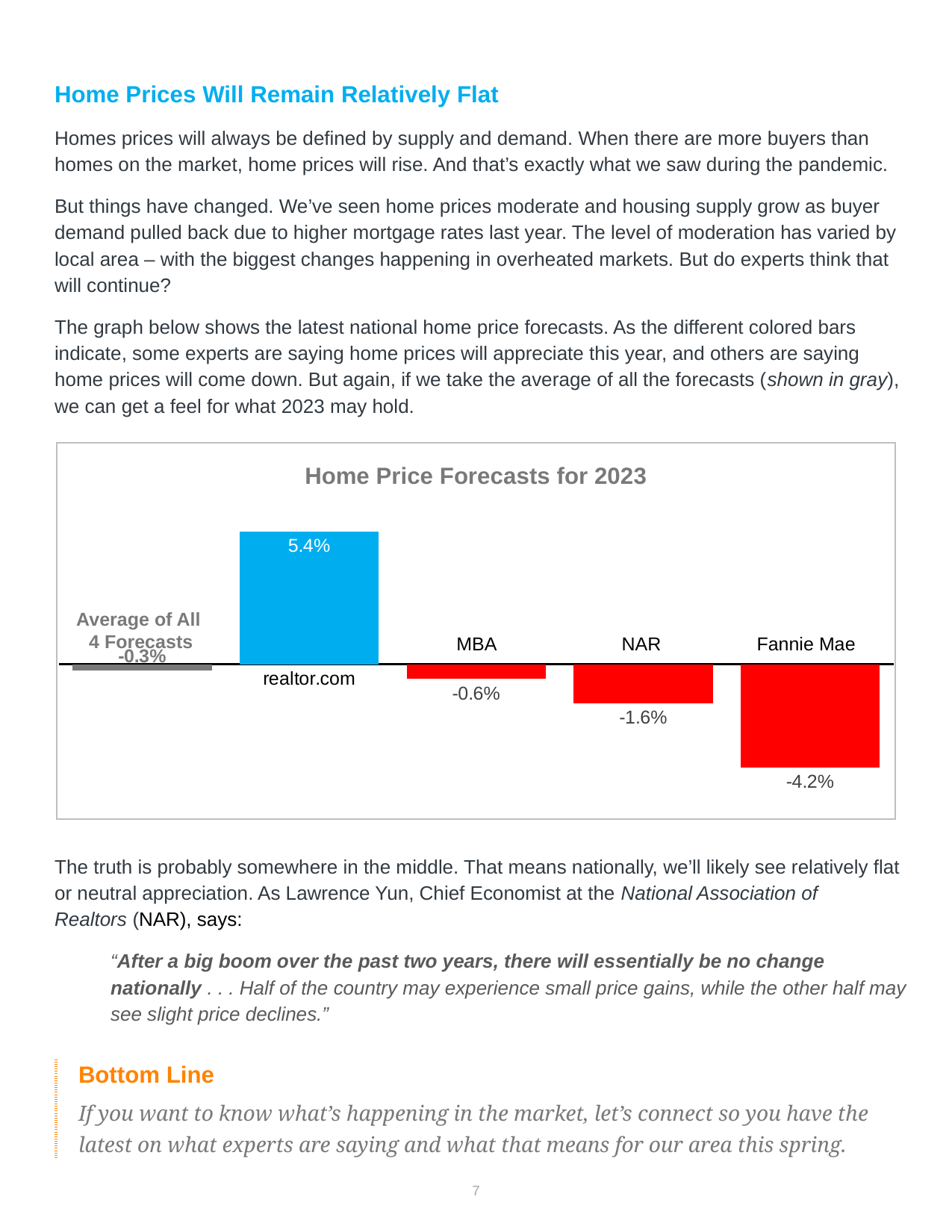
What is the title of the chart? Home Price Forecasts for 2023 Which is larger, the MBA forecast or the NAR forecast? MBA What is the home price forecast for 2023 from Fannie Mae? -4.2% Which forecaster has the highest home price forecast for 2023? realtor.com What is the home price forecast for 2023 from NAR? -1.6% How many bars are plotted in the chart? 5 What is the value shown for the Average of All 4 Forecasts? -0.3% What color is the bar for the Average of All 4 Forecasts? gray What is the home price forecast for 2023 from realtor.com? 5.4% What kind of chart is shown on the slide? bar chart What is the difference between the realtor.com forecast and the Fannie Mae forecast? 9.6 percentage points Which forecaster has the lowest home price forecast for 2023? Fannie Mae